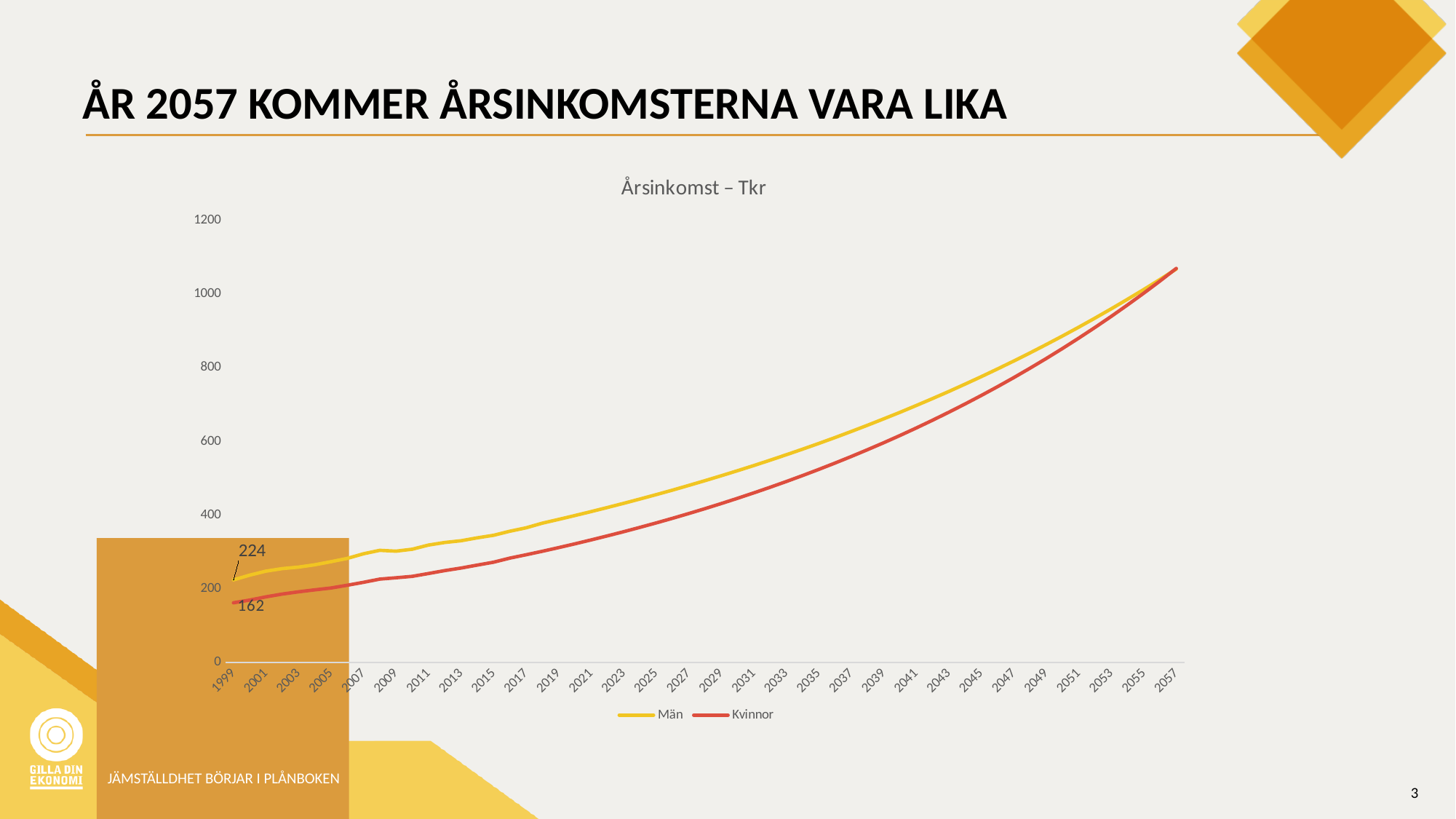
In 1999, which series has the higher value, Män or Kvinnor? Män Is the value for Kvinnor in 2045 greater or less than 600? greater Is the value for Män in 2057 greater or less than 1000? greater Is the value for Män in 2049 greater or less than 800? greater What kind of chart is shown on the slide? Line chart What is the difference between the Män and Kvinnor values in 1999? 62 What is the value for Män in 1999? 224 How many series does the legend list? 2 Which series is higher in 2031, Män or Kvinnor? Män Do the values for Kvinnor rise or fall from 1999 to 2057? Rise What is the value for Kvinnor in 1999? 162